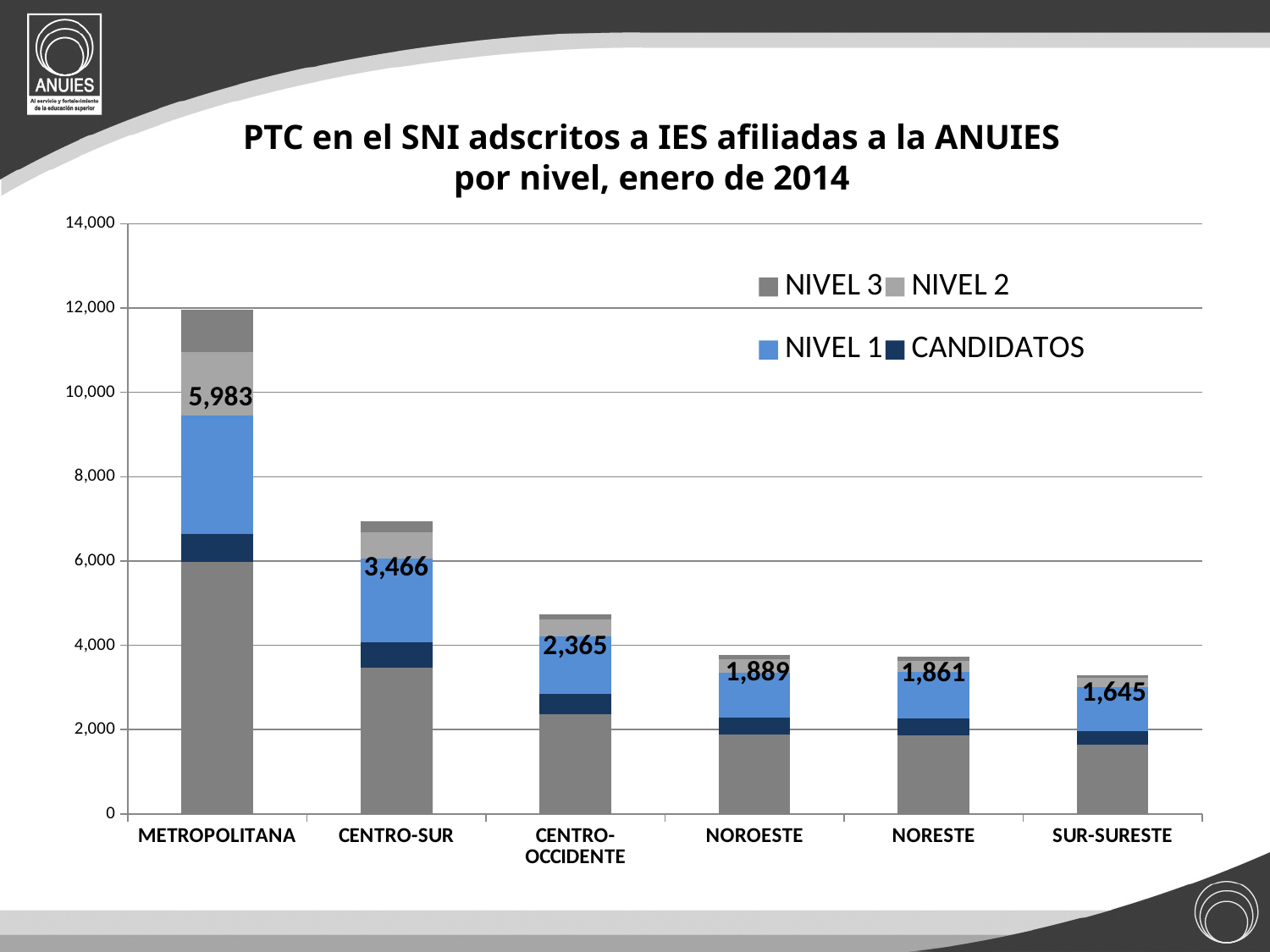
Which region has the shortest stacked bar? SUR-SURESTE What value is printed on the CENTRO-SUR bar? 3,466 How many series does the legend list? 4 What is the difference between the value printed on the METROPOLITANA bar and the value printed on the CENTRO-SUR bar? 2,517 What value is printed on the METROPOLITANA bar? 5,983 How many regions are shown along the x axis? 6 What value is printed on the SUR-SURESTE bar? 1,645 Which region has the tallest stacked bar? METROPOLITANA Is the total height of the METROPOLITANA stacked bar greater or less than 10,000? greater What is the title of the chart? PTC en el SNI adscritos a IES afiliadas a la ANUIES por nivel, enero de 2014 Which has the larger printed value, NOROESTE or NORESTE? NOROESTE What kind of chart is shown on the slide? Stacked bar chart